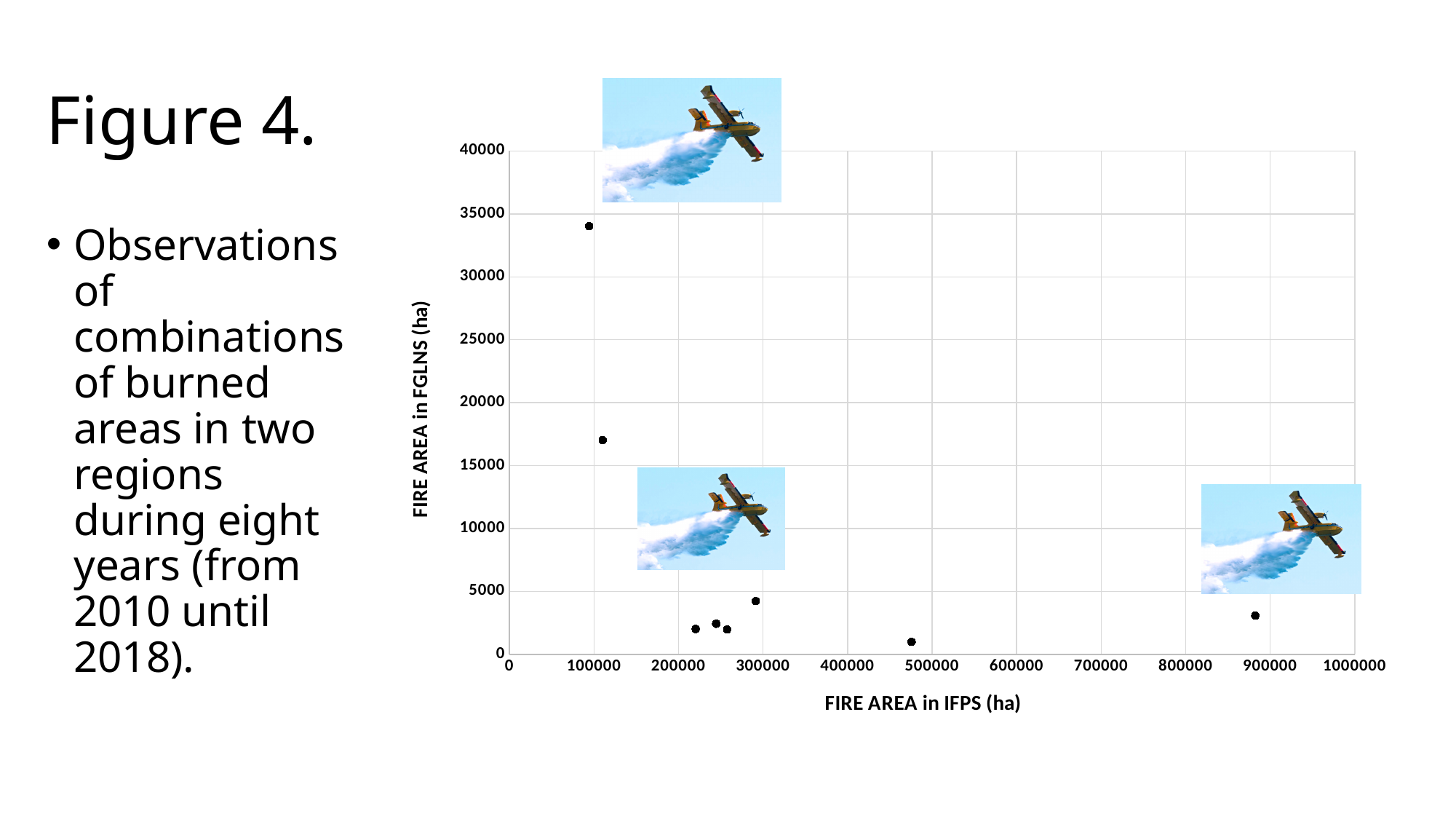
Is the FIRE AREA in FGLNS value of the second-highest point on the chart greater or less than 15000? greater What kind of chart is shown on the slide? scatter chart Is the FIRE AREA in FGLNS value of the point near 500000 ha in IFPS greater or less than 5000? less Which has the larger FIRE AREA in FGLNS value: the point near 100000 ha in IFPS or the point near 900000 ha in IFPS? the point near 100000 ha in IFPS Is the FIRE AREA in FGLNS value of the highest point on the chart greater or less than 30000? greater What is the label of the x axis of the chart? FIRE AREA in IFPS (ha) What is the label of the y axis of the chart? FIRE AREA in FGLNS (ha) Do the FIRE AREA in FGLNS values generally rise or fall as FIRE AREA in IFPS increases along the x axis? fall